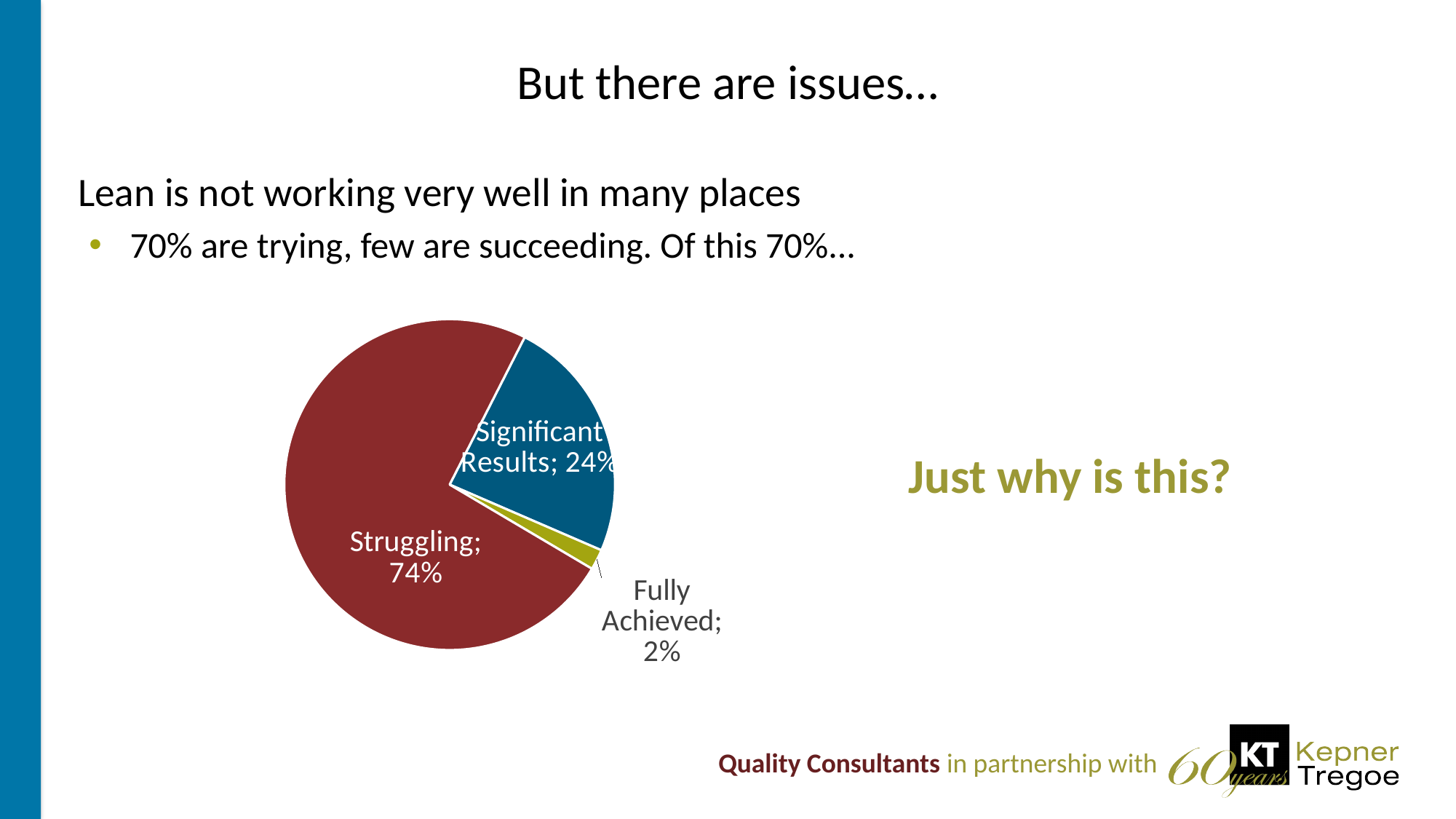
What percentage of the pie is labelled Significant Results? 24% Which is larger, the Significant Results slice or the Fully Achieved slice? Significant Results How many slices does the pie chart have? 3 What is the difference in percentage points between the Struggling slice and the Significant Results slice? 50 Which slice of the pie is the largest? Struggling Which slice of the pie is the smallest? Fully Achieved What percentage of the pie is labelled Struggling? 74% What colour is the Struggling slice of the pie? Dark red What is the combined share of the Significant Results and Fully Achieved slices? 26% What colour is the Significant Results slice of the pie? Blue What kind of chart is shown on the slide? Pie chart What percentage of the pie is labelled Fully Achieved? 2%